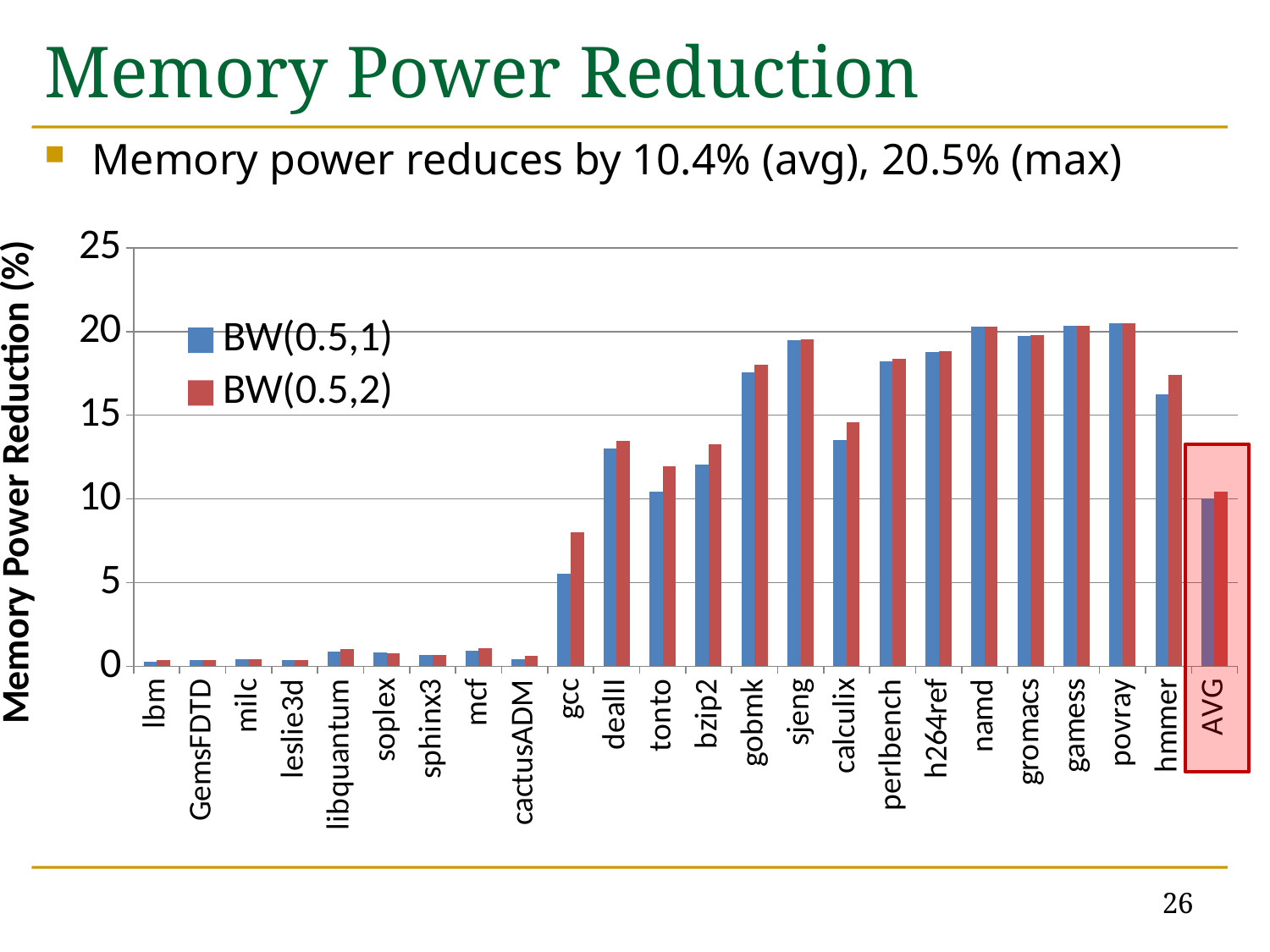
How many categories are shown along the x axis? 24 How many series does the legend list? 2 Is the BW(0.5,2) value for gcc greater or less than 5? greater Is the BW(0.5,2) value for calculix greater or less than 15? less What is the label of the y axis? Memory Power Reduction (%) Is the BW(0.5,1) value for dealII greater or less than 10? greater What kind of chart is shown on the slide? bar chart For gcc, which series has the larger value, BW(0.5,1) or BW(0.5,2)? BW(0.5,2) What are the two series named in the legend? BW(0.5,1) and BW(0.5,2) For BW(0.5,1), which has the larger value, tonto or bzip2? bzip2